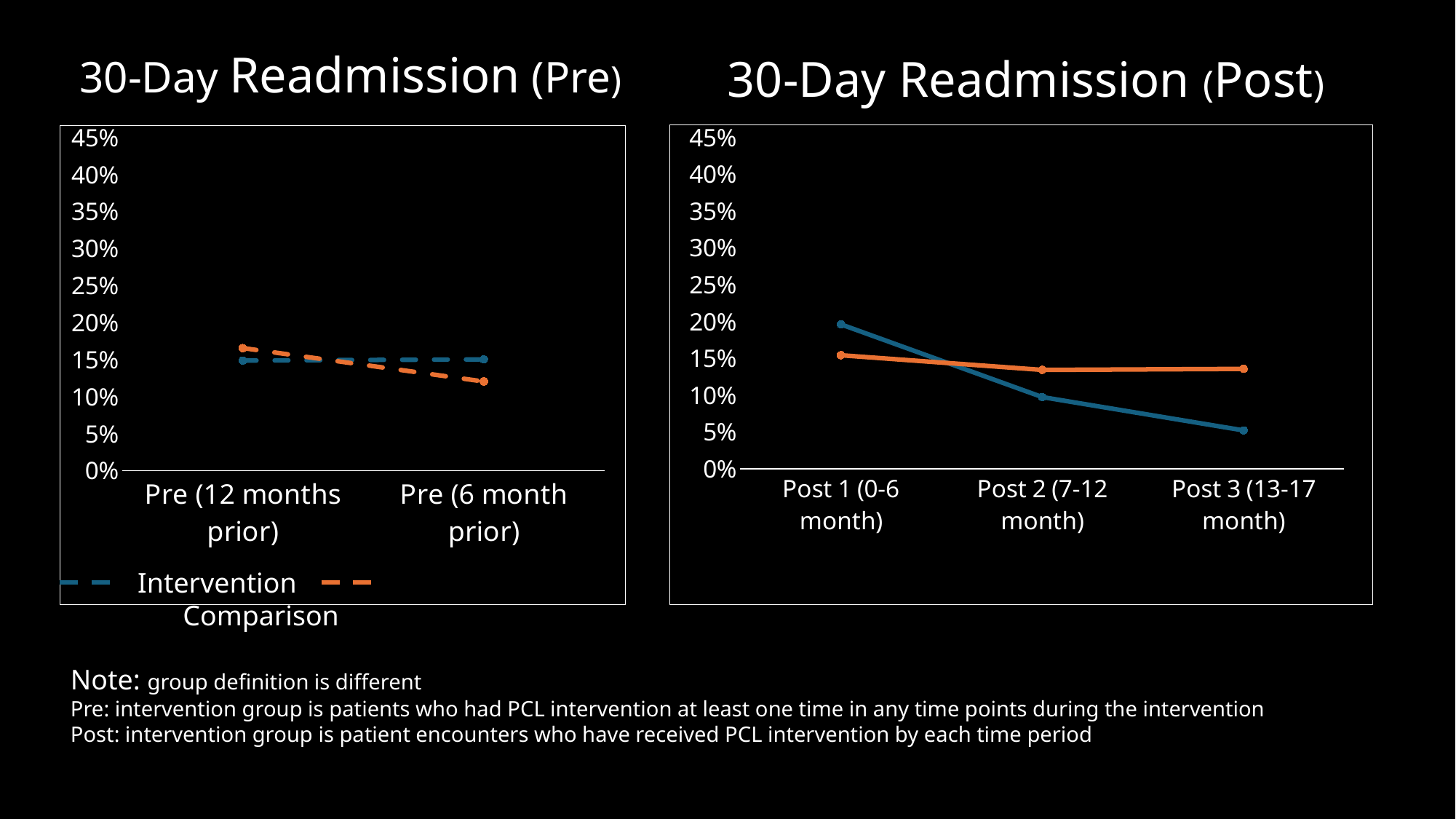
In the 30-Day Readmission (Post) chart, does the Intervention line rise or fall from Post 1 to Post 3? fall How many series does the legend of the 30-Day Readmission (Pre) chart list? 2 In the 30-Day Readmission (Post) chart, is the Intervention value at Post 1 (0-6 month) greater or less than 15%? greater What kind of chart is the 30-Day Readmission (Post) chart? line chart In the 30-Day Readmission (Post) chart, is the Intervention value at Post 3 (13-17 month) greater or less than 10%? less In the 30-Day Readmission (Pre) chart, is the Comparison value at Pre (6 month prior) greater or less than 15%? less In the 30-Day Readmission (Post) chart, at which time point is the Intervention value highest? Post 1 (0-6 month) In the 30-Day Readmission (Post) chart, which series has the higher value at Post 1 (0-6 month), Intervention or Comparison? Intervention How many time points are shown on the x axis of the 30-Day Readmission (Post) chart? 3 In the 30-Day Readmission (Post) chart, which series has the higher value at Post 3 (13-17 month), Intervention or Comparison? Comparison In the 30-Day Readmission (Pre) chart, which series is drawn in orange? Comparison How many categories are shown on the x axis of the 30-Day Readmission (Pre) chart? 2